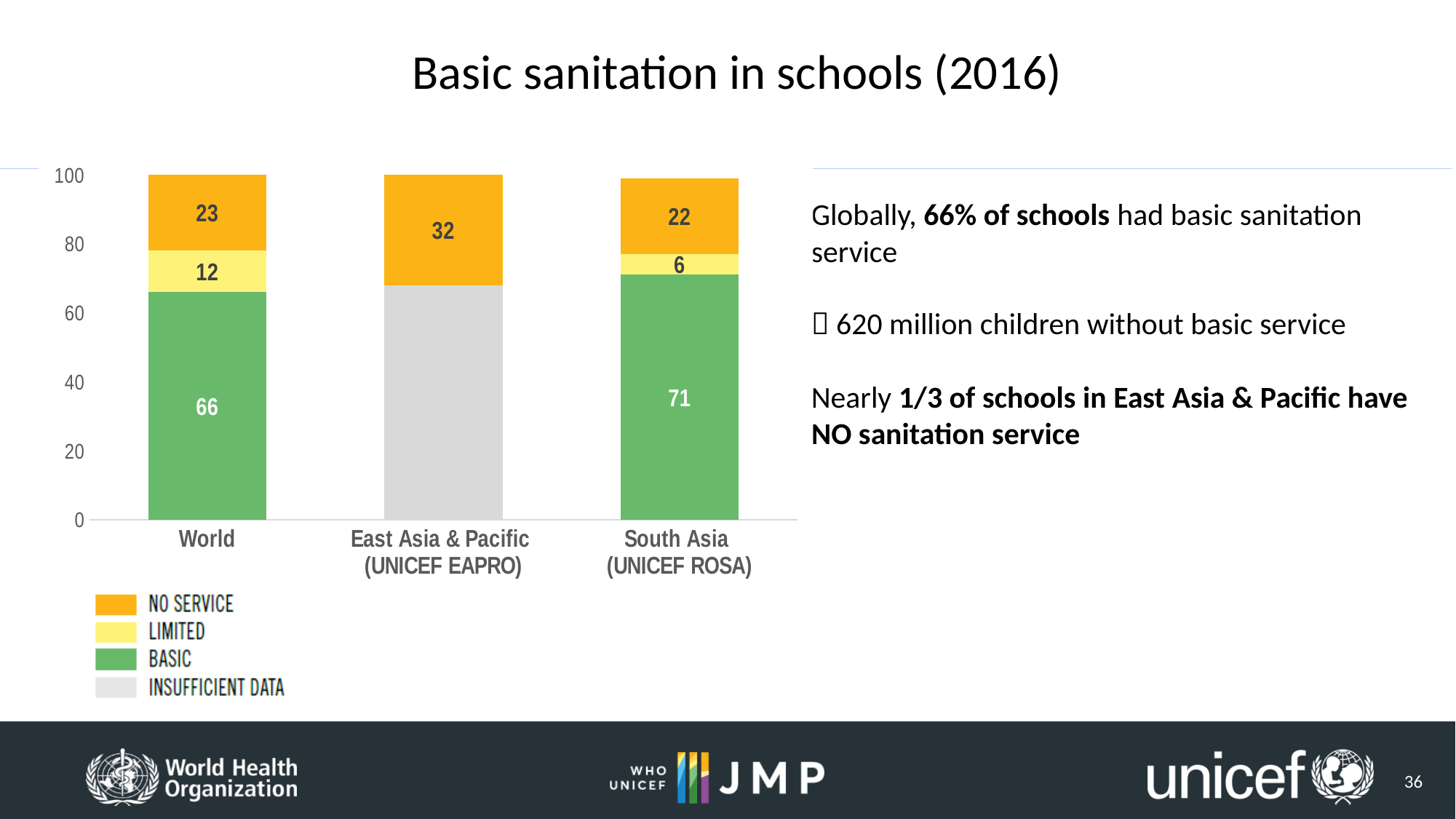
Is the Insufficient Data value for East Asia & Pacific (UNICEF EAPRO) greater or less than 60? greater How many series does the legend list? 4 What is the Limited value for South Asia (UNICEF ROSA)? 6 Is the Limited value larger for World or for South Asia (UNICEF ROSA)? World How many regions are shown on the x axis? 3 What is the No Service value for World? 23 What type of chart is shown on the slide? Stacked bar chart Which region has the lowest No Service value? South Asia (UNICEF ROSA) Which region has the highest No Service value? East Asia & Pacific (UNICEF EAPRO) What is the No Service value for East Asia & Pacific (UNICEF EAPRO)? 32 What is the difference between the Basic value for South Asia (UNICEF ROSA) and the Basic value for World? 5 What is the Basic value for World? 66